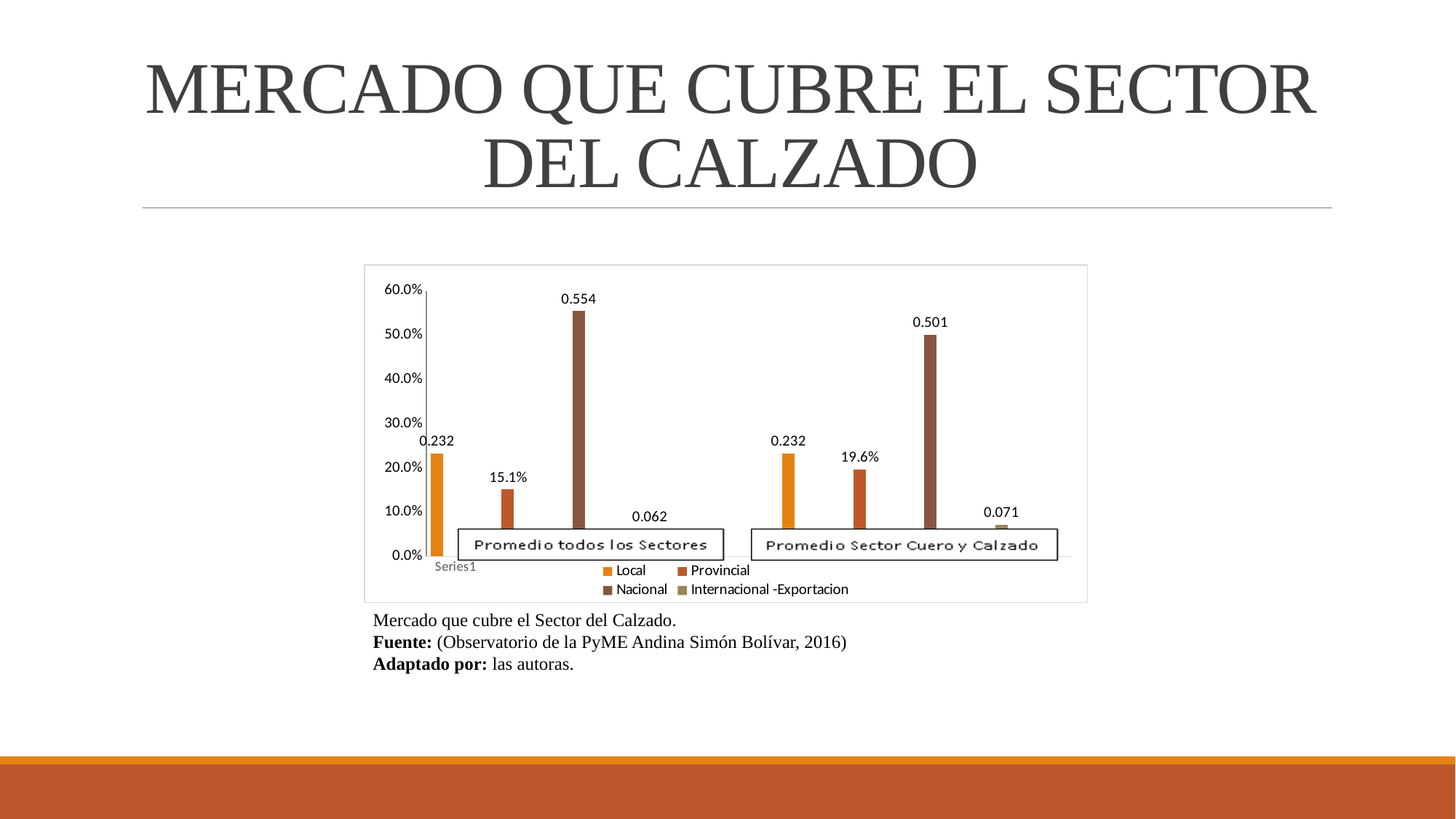
Is the Nacional value for Promedio Sector Cuero y Calzado greater or less than 40.0%? greater How many series does the legend list? 4 What is the value of the Provincial bar for Promedio Sector Cuero y Calzado? 19.6% Which series has the highest value in the Promedio Sector Cuero y Calzado group? Nacional Which is larger: the Nacional value for Promedio todos los Sectores or the Nacional value for Promedio Sector Cuero y Calzado? Promedio todos los Sectores What is the difference between the Nacional values for Promedio todos los Sectores and Promedio Sector Cuero y Calzado? 0.053 What kind of chart is shown on the slide? Bar chart What colour are the Local bars in the chart? Orange What is the value of the Local bar for Promedio Sector Cuero y Calzado? 0.232 What is the value of the Internacional -Exportacion bar for Promedio todos los Sectores? 0.062 Which series has the lowest value in the Promedio todos los Sectores group? Internacional -Exportacion What is the value of the Nacional bar for Promedio todos los Sectores? 0.554